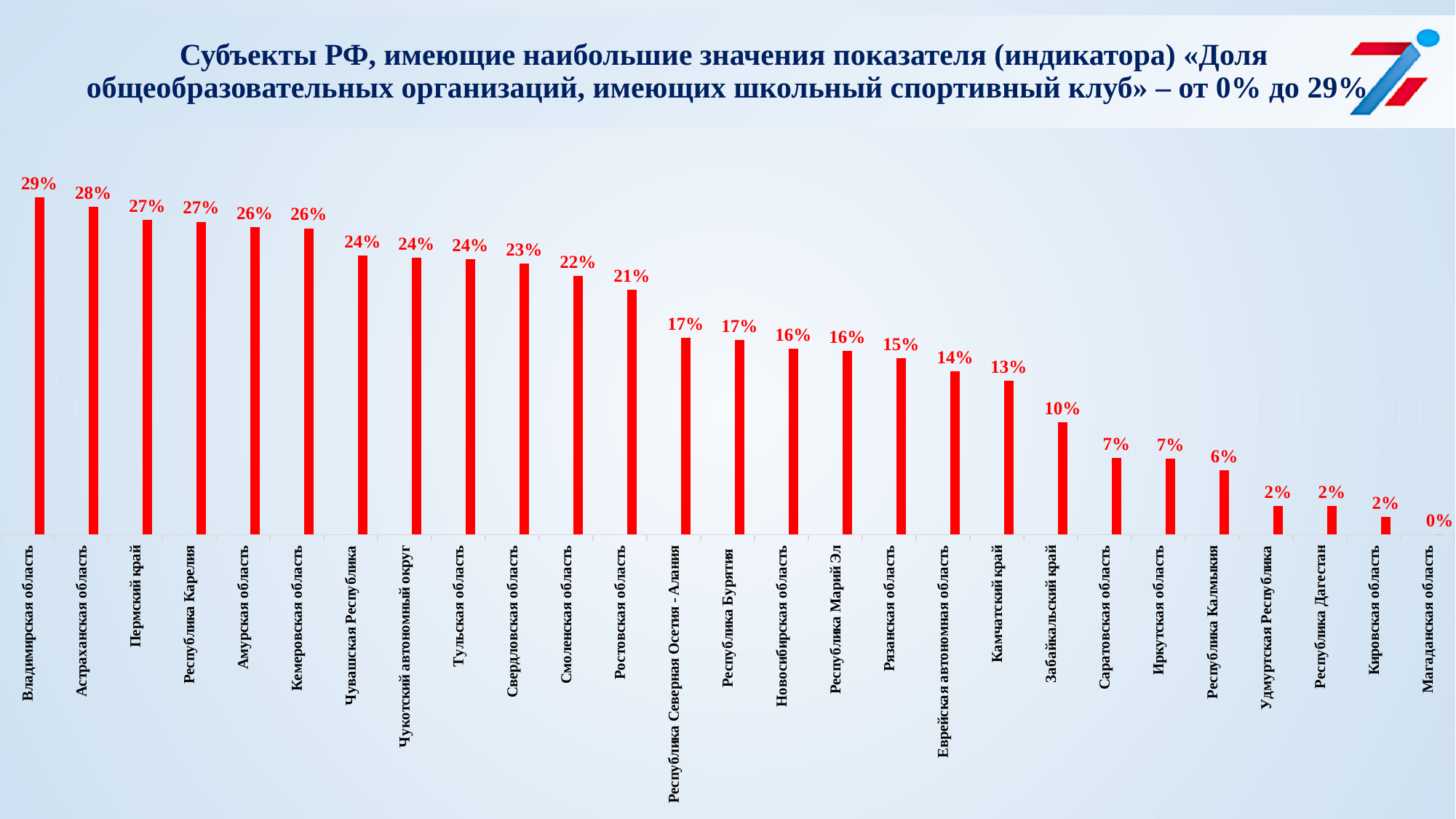
What is the value for Ростовская область? 21% What kind of chart is shown on the slide? Bar chart Do the values rise or fall from left to right along the x axis? Fall How many regions are shown on the chart? 27 What is the difference between the values for Астраханская область and Забайкальский край? 18% What is the value for Камчатский край? 13% Which is larger, the value for Тульская область or the value for Новосибирская область? Тульская область What colour are the bars on the chart? Red What is the value for Владимирская область? 29% What is the value for Республика Калмыкия? 6% Which region has the lowest value on the chart? Магаданская область Which region has the highest value on the chart? Владимирская область